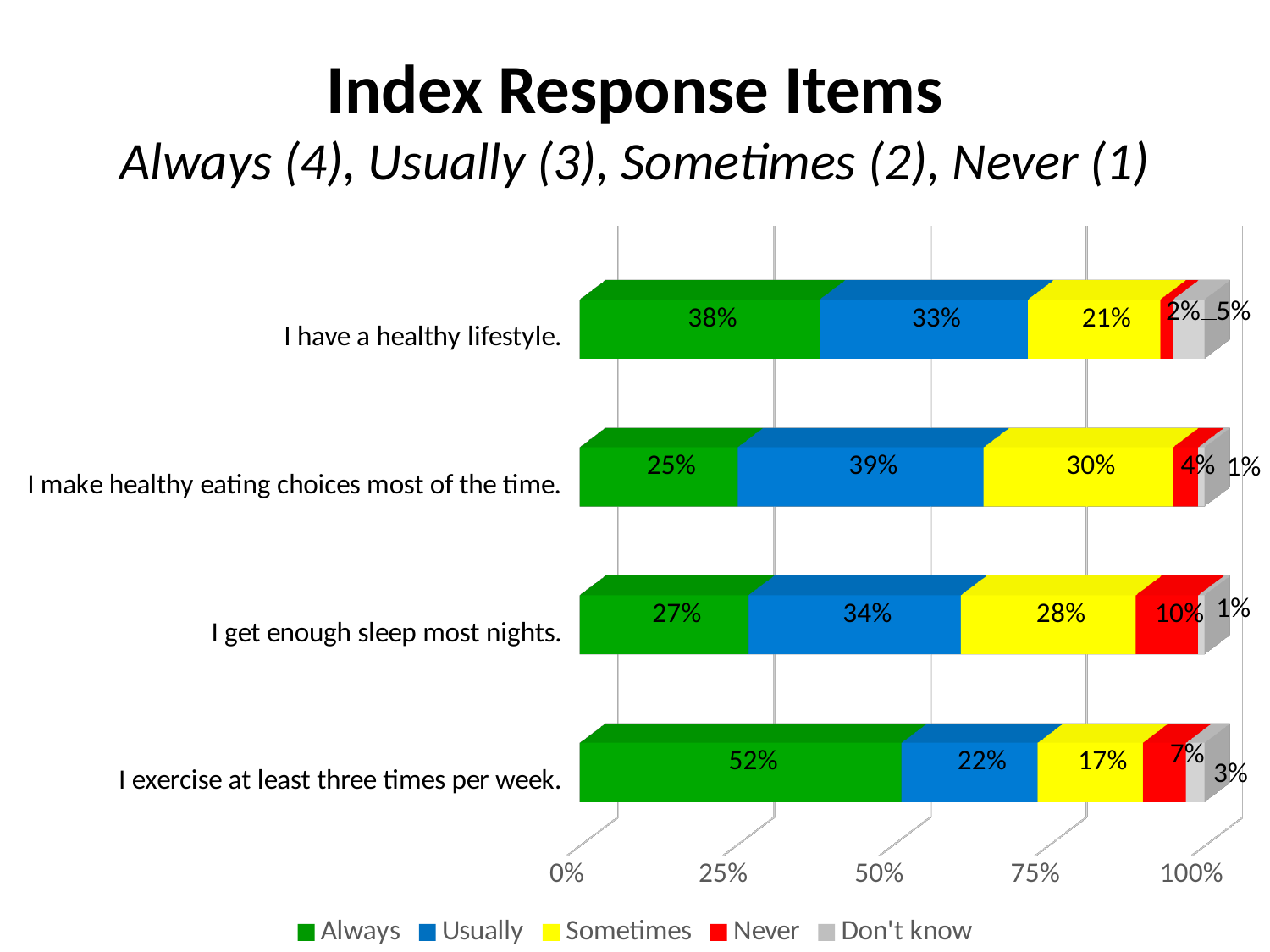
What is the 'Don't know' value for 'I have a healthy lifestyle.'? 5% What is the difference between the 'Always' values for 'I have a healthy lifestyle.' and 'I make healthy eating choices most of the time.'? 13% Which is larger: the 'Usually' value for 'I get enough sleep most nights.' or the 'Usually' value for 'I have a healthy lifestyle.'? I get enough sleep most nights. How many response items (categories) are plotted in the chart? 4 What is the 'Usually' value for 'I make healthy eating choices most of the time.'? 39% What type of chart is shown on the slide? stacked bar chart What colour represents the 'Never' series in the chart? red What is the 'Never' value for 'I get enough sleep most nights.'? 10% Which item has the highest 'Always' value? I exercise at least three times per week. What is the 'Always' value for 'I exercise at least three times per week.'? 52% Which item has the lowest 'Sometimes' value? I exercise at least three times per week. How many series does the legend list? 5